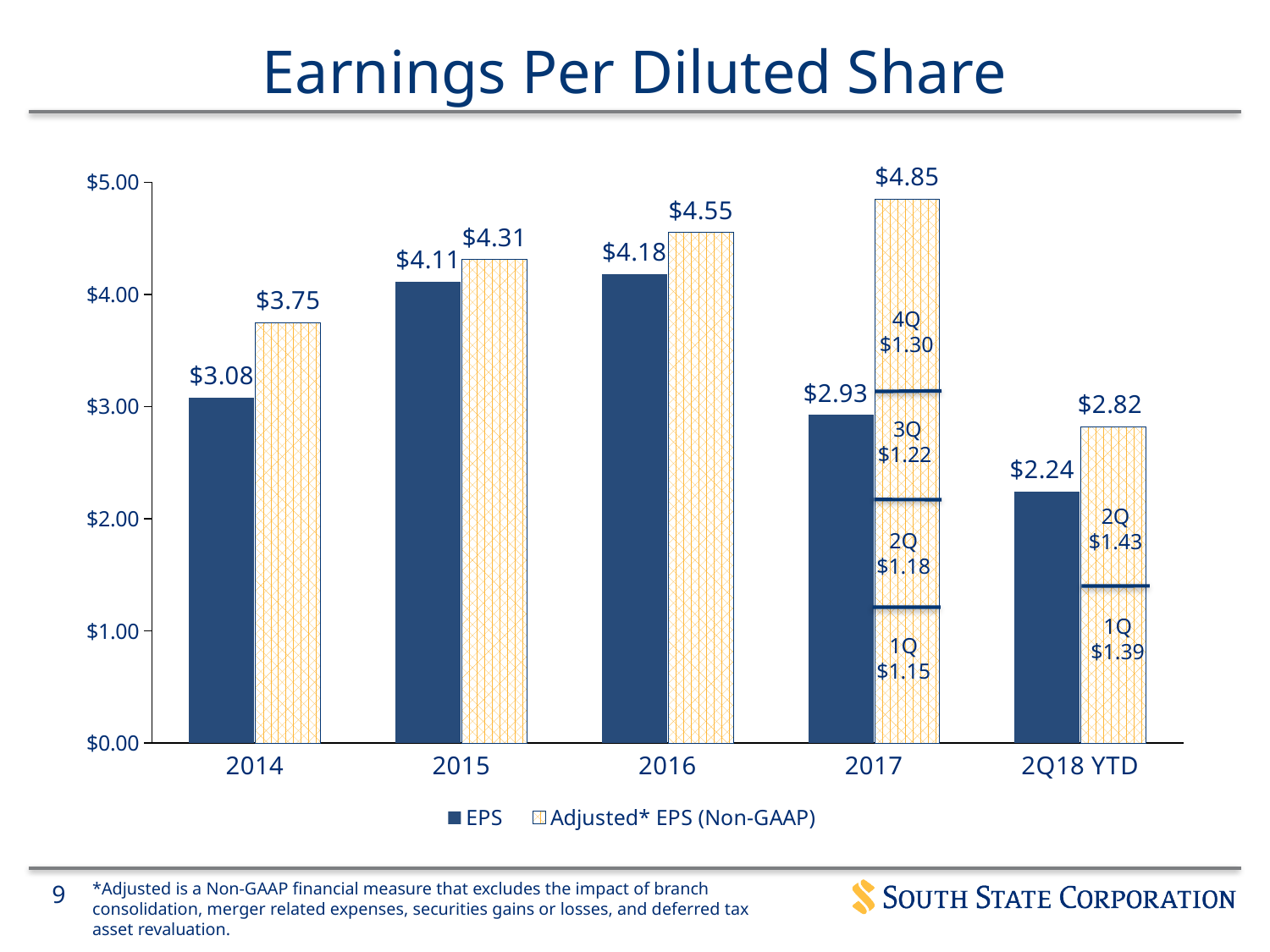
What is the Adjusted* EPS (Non-GAAP) value for 2Q18 YTD? $2.82 Is the EPS value for 2016 greater or less than $4.00? greater How many series does the legend list? 2 What kind of chart is shown on the slide? Bar chart Which is larger for 2015: EPS or Adjusted* EPS (Non-GAAP)? Adjusted* EPS (Non-GAAP) What is the difference between the Adjusted* EPS (Non-GAAP) and EPS values for 2017? $1.92 Which year has the highest Adjusted* EPS (Non-GAAP) value? 2017 What is the 3Q portion of the 2017 Adjusted* EPS (Non-GAAP) bar? $1.22 How many categories are shown on the x axis? 5 Which category has the lowest EPS value? 2Q18 YTD What is the EPS value for 2014? $3.08 What is the Adjusted* EPS (Non-GAAP) value for 2016? $4.55